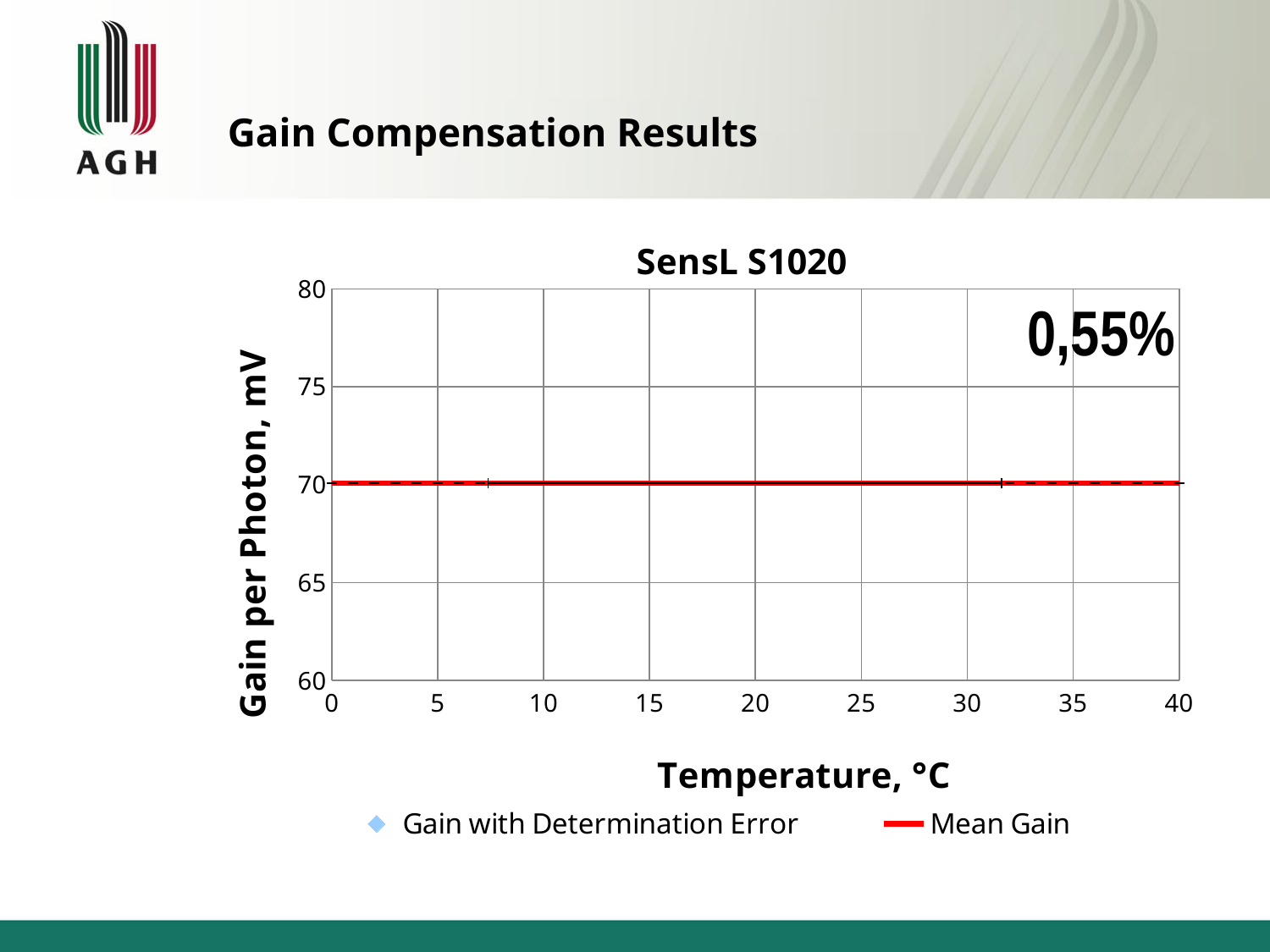
How many series does the chart legend list? 2 Is the Mean Gain value greater or less than 65? greater What value does the Mean Gain line sit at on the y axis? 70 What is the minimum value shown on the y axis? 60 What is the label of the y axis? Gain per Photon, mV Does the Mean Gain rise, fall, or stay flat as temperature increases from 0 to 40 °C? stays flat What is the title of the chart? SensL S1020 What percentage value is printed in the upper right of the plot area? 0,55% Is the Mean Gain value greater or less than 75? less What kind of chart is shown on the slide? line chart What is the maximum value shown on the x axis (Temperature, °C)? 40